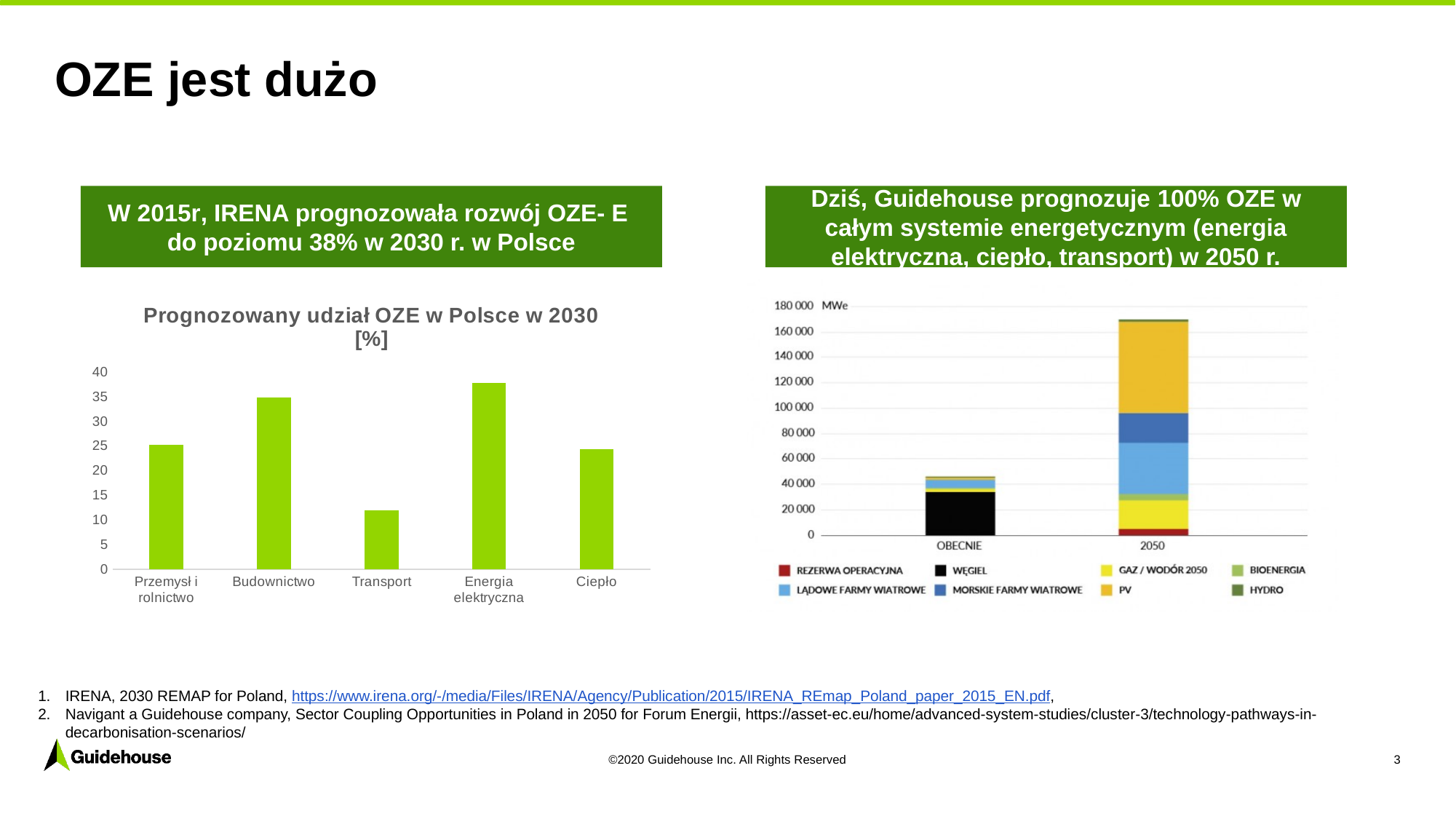
In the left chart 'Prognozowany udział OZE w Polsce w 2030 [%]', is the value for Budownictwo greater or less than 30? greater In the left chart 'Prognozowany udział OZE w Polsce w 2030 [%]', is the value for Transport greater or less than 15? less In the left chart 'Prognozowany udział OZE w Polsce w 2030 [%]', how many categories are shown? 5 In the left chart 'Prognozowany udział OZE w Polsce w 2030 [%]', is the value for Przemysł i rolnictwo greater or less than 20? greater In the left chart 'Prognozowany udział OZE w Polsce w 2030 [%]', which category has the highest value? Energia elektryczna In the left chart 'Prognozowany udział OZE w Polsce w 2030 [%]', which category has the lowest value? Transport In the left chart 'Prognozowany udział OZE w Polsce w 2030 [%]', which is larger: Budownictwo or Ciepło? Budownictwo In the right chart (stacked bars for OBECNIE and 2050), how many series does the legend list? 8 In the right chart (stacked bars for OBECNIE and 2050), how many categories are on the x axis? 2 In the right chart (stacked bars for OBECNIE and 2050), which legend entry is shown in black? WĘGIEL What kind of chart is the left chart titled 'Prognozowany udział OZE w Polsce w 2030 [%]'? bar chart